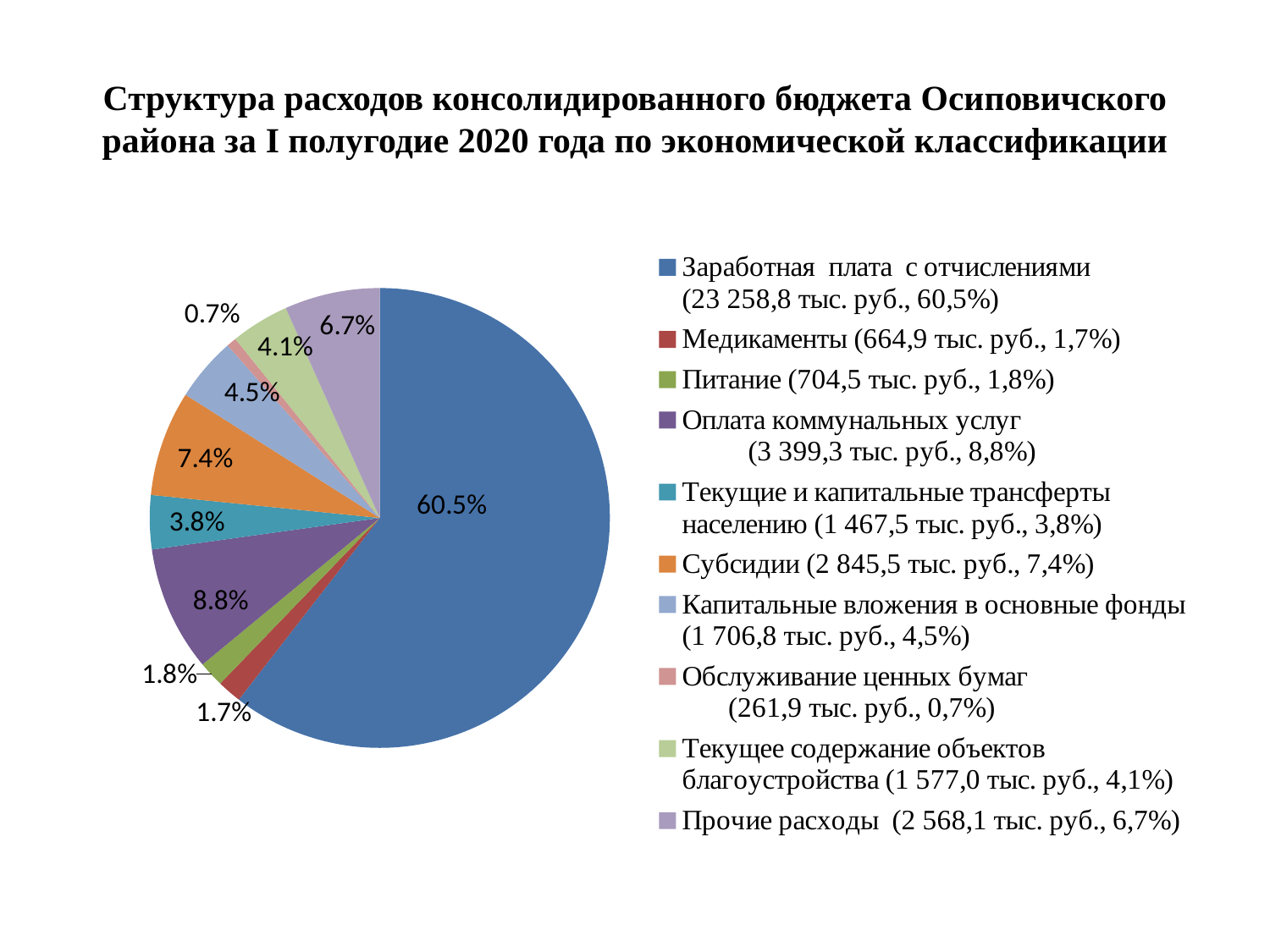
What percentage is shown for Субсидии? 7.4% Which category has the largest share of the pie? Заработная плата с отчислениями What percentage is shown for Прочие расходы? 6.7% What is the difference in percentage points between Капитальные вложения в основные фонды (4.5%) and Текущее содержание объектов благоустройства (4.1%)? 0.4% Which category has the smallest share of the pie? Обслуживание ценных бумаг What kind of chart is shown on the slide? pie chart According to the legend, what is the amount for Медикаменты in thousand rubles? 664,9 тыс. руб. Which period does the chart title say the expenditure structure refers to? I полугодие 2020 года What share of the pie does Оплата коммунальных услуг have? 8.8% Which is larger: the share for Питание or the share for Медикаменты? Питание What is the difference in percentage points between Заработная плата с отчислениями and Оплата коммунальных услуг? 51.7% How many slices does the pie chart have? 10